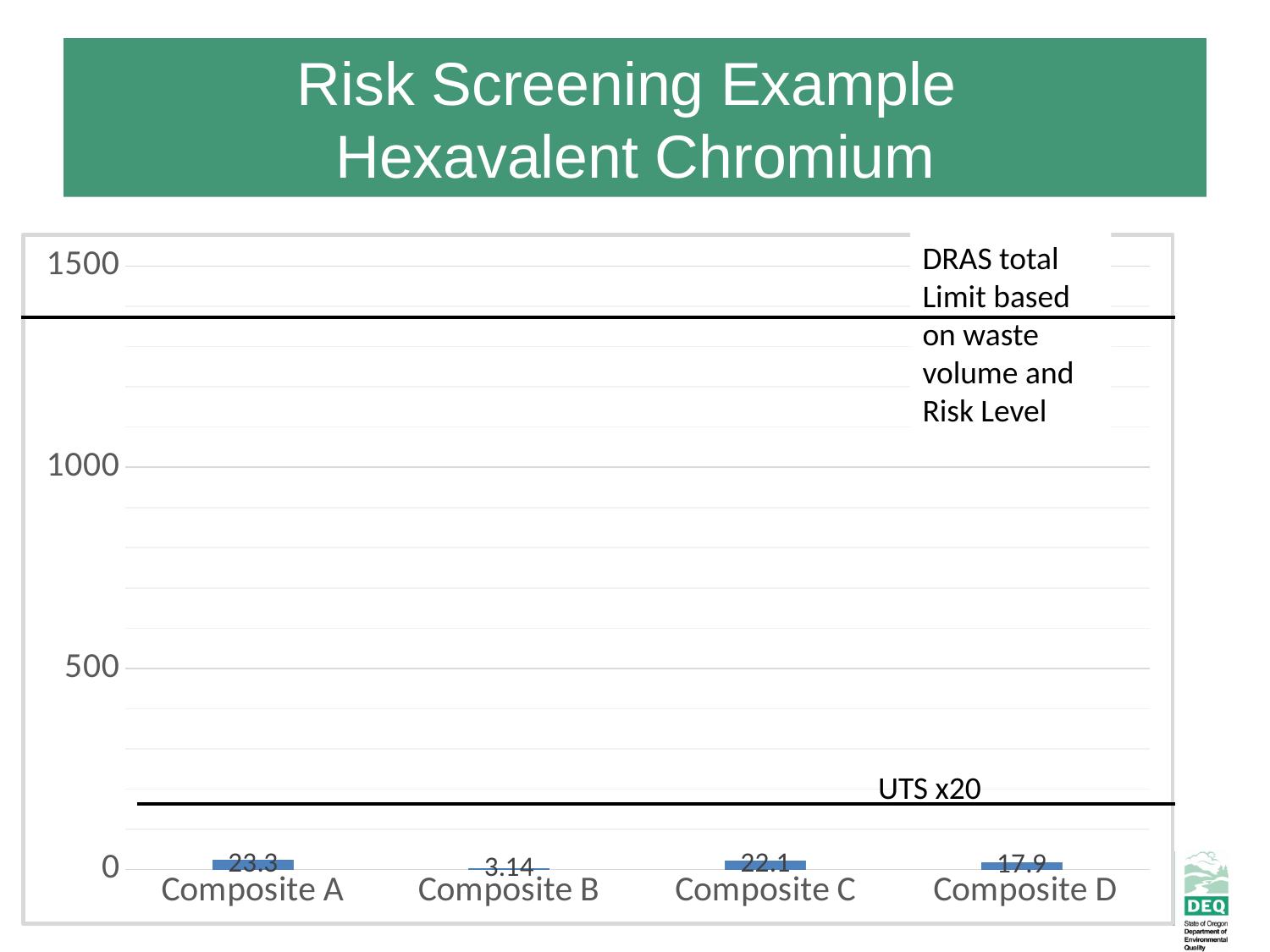
What is the value for Composite D? 17.9 Which composite has the lowest value? Composite B What kind of chart is shown on the slide? bar chart What is the difference between the values for Composite A and Composite B? 20.16 Which is larger, the value for Composite C or the value for Composite D? Composite C How many composites are plotted on the chart? 4 What is the value for Composite B? 3.14 What is the value for Composite C? 22.1 Is the value for Composite A greater or less than 500? less Which composite has the highest value? Composite A What is the value for Composite A? 23.3 What is the label of the lower horizontal reference line on the chart? UTS x20